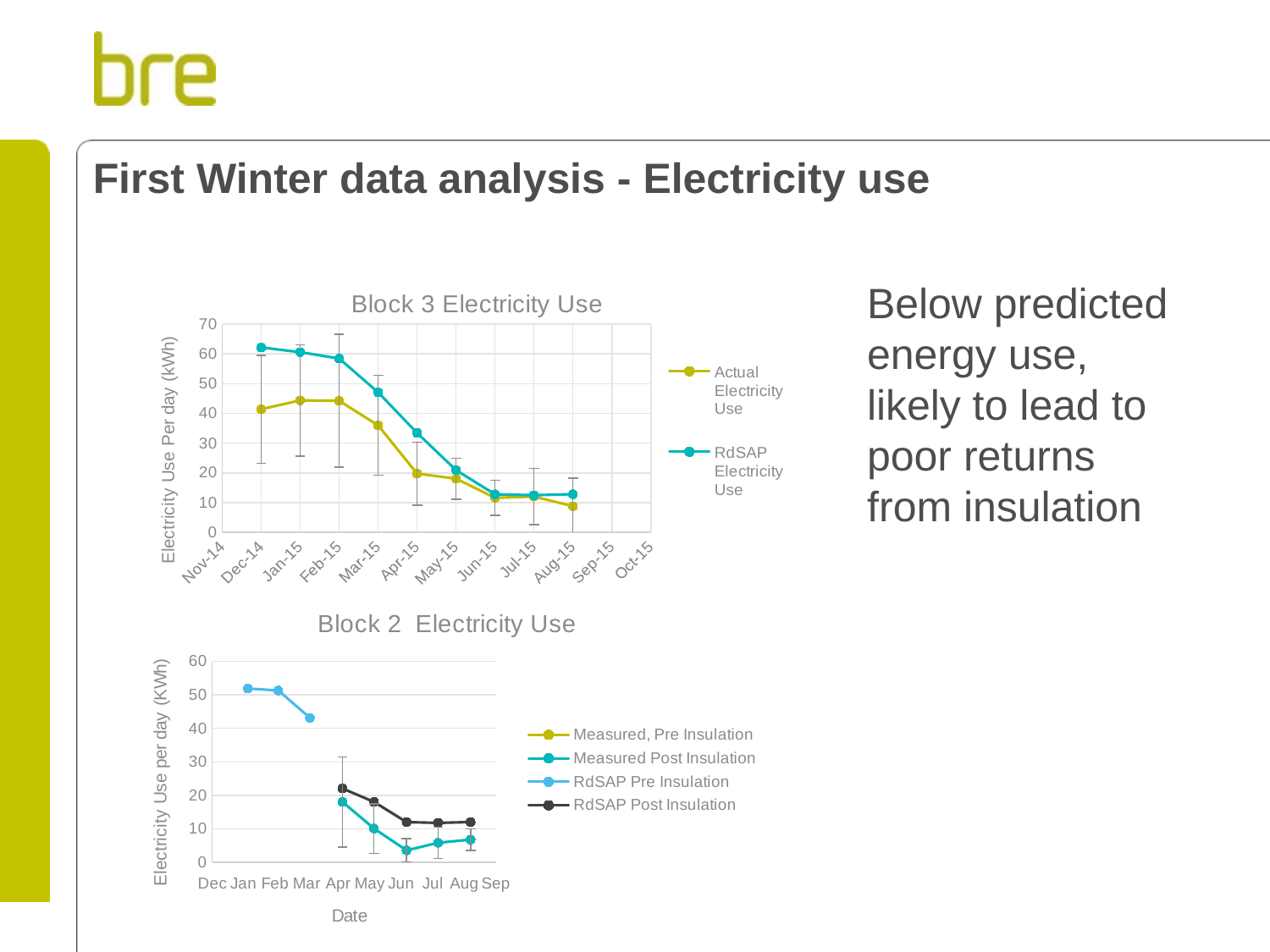
In the Block 3 Electricity Use chart, which series has the higher value in Dec-14, Actual Electricity Use or RdSAP Electricity Use? RdSAP Electricity Use In the Block 3 Electricity Use chart, does the RdSAP Electricity Use series rise or fall from Dec-14 to Jun-15? fall In the Block 3 Electricity Use chart, is the Actual Electricity Use value for Apr-15 greater or less than 30? less What kind of chart is the Block 3 Electricity Use chart? line chart In the Block 2 Electricity Use chart, is the Measured Post Insulation value for Jun greater or less than 10? less In the Block 2 Electricity Use chart, how many month labels are shown on the x axis? 10 In the Block 3 Electricity Use chart, how many series does the legend list? 2 In the Block 2 Electricity Use chart, is the RdSAP Pre Insulation value for Dec greater or less than 40? greater In the Block 2 Electricity Use chart, how many series does the legend list? 4 In the Block 2 Electricity Use chart, which series has the higher value in Apr, RdSAP Post Insulation or Measured Post Insulation? RdSAP Post Insulation In the Block 2 Electricity Use chart, what is the title of the x axis? Date